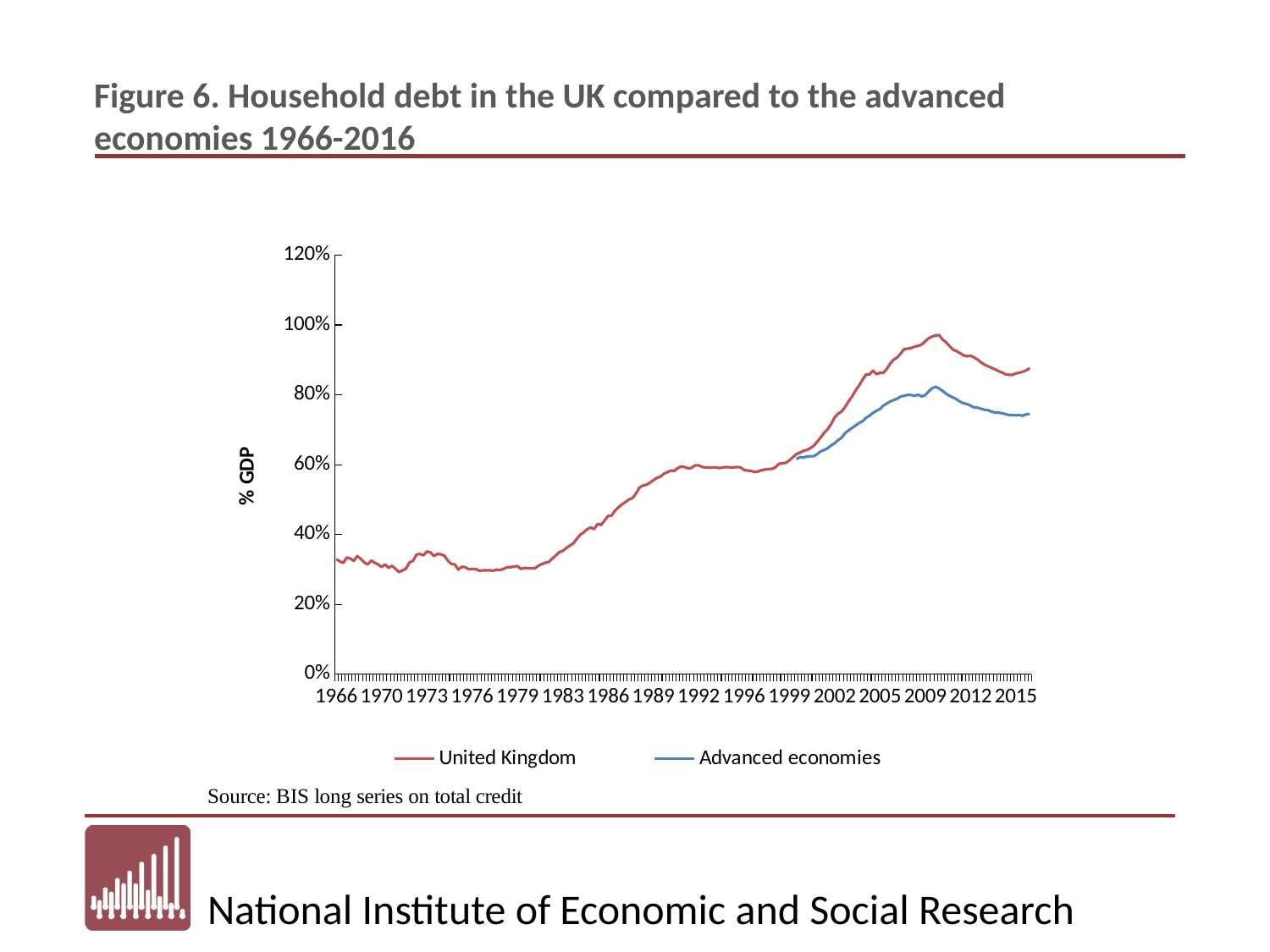
What is the label on the vertical axis of the chart? % GDP Is the value for the United Kingdom around 2009 greater or less than 80%? greater How many series does the legend list? 2 In 2015, which series has the higher value, United Kingdom or Advanced economies? United Kingdom Is the value for the United Kingdom in 1966 greater or less than 20%? greater Is the value for the United Kingdom in 1966 greater or less than 40%? less What kind of chart is shown on the slide? Line chart Does the Advanced economies series rise or fall between 2009 and 2015? Fall Which series is drawn in blue in the chart? Advanced economies Does the United Kingdom series rise or fall between 1983 and 2009? Rise